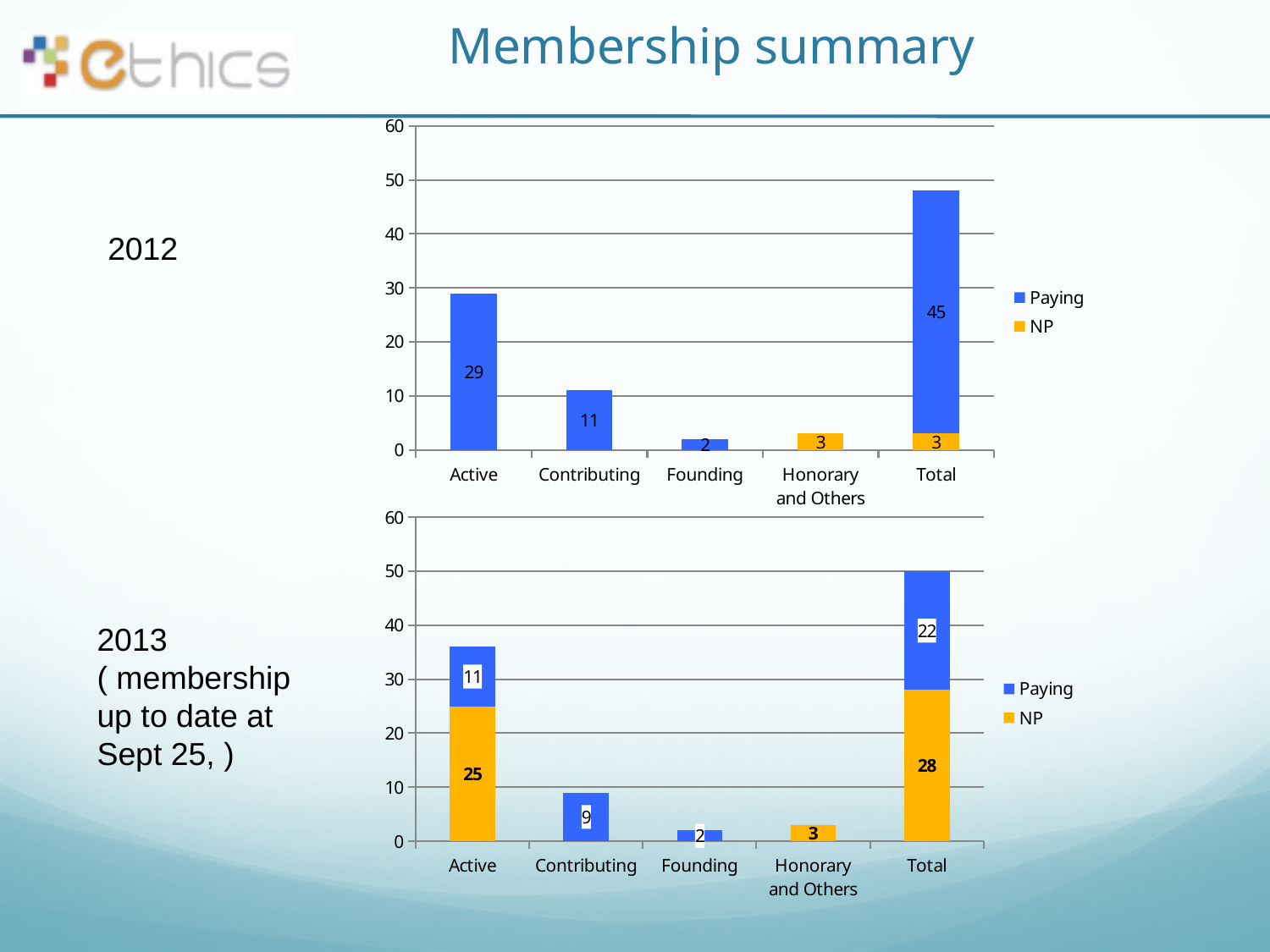
In the 2013 chart (bottom), what is the difference between the NP value for Total and the NP value for Active? 3 In the 2013 chart (bottom), which category has the lowest bar? Founding In the 2012 chart (top), what is the Paying value for Active? 29 In the 2012 chart (top), what is the Paying value for Contributing? 11 How many categories are shown on the x axis of the 2012 chart (top)? 5 In the 2012 chart (top), what is the NP value for Honorary and Others? 3 In the 2013 chart (bottom), what is the Paying value for Total? 22 In the 2012 chart (top), is the Paying value for Active larger or smaller than the Paying value for Contributing? larger In the 2013 chart (bottom), what is the NP value for Active? 25 How many series does the legend of the 2013 chart (bottom) list? 2 In the 2012 chart (top), what is the combined height of the stacked Total bar (Paying plus NP)? 48 In the 2013 chart (bottom), what is the combined height of the stacked Total bar (Paying plus NP)? 50